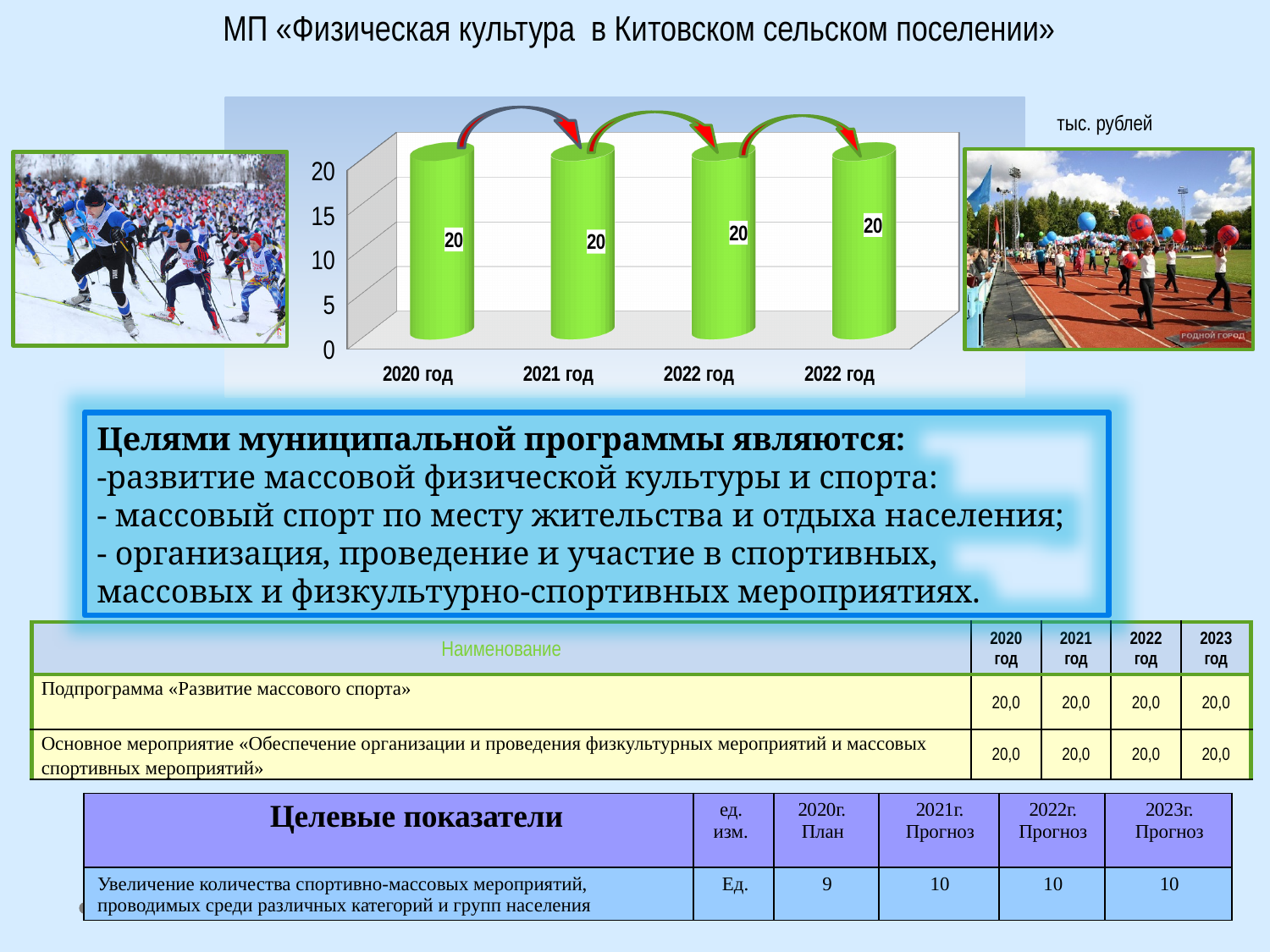
What is the difference between the values for 2020 год and 2021 год? 0 Is the value for 2020 год larger than, smaller than, or equal to the value for 2021 год? equal What is the value for 2021 год in the chart? 20 Do the values rise, fall or stay the same across the years on the x axis? stay the same What kind of chart is shown on the slide? bar chart Is the value for 2020 год greater or less than 10? greater Is the value for 2021 год greater or less than 15? greater Which x-axis label appears twice in the chart? 2022 год What is the value for 2020 год in the chart? 20 What unit is indicated next to the chart? тыс. рублей How many bars does the chart show? 4 What value is labelled on the bar for 2022 год? 20